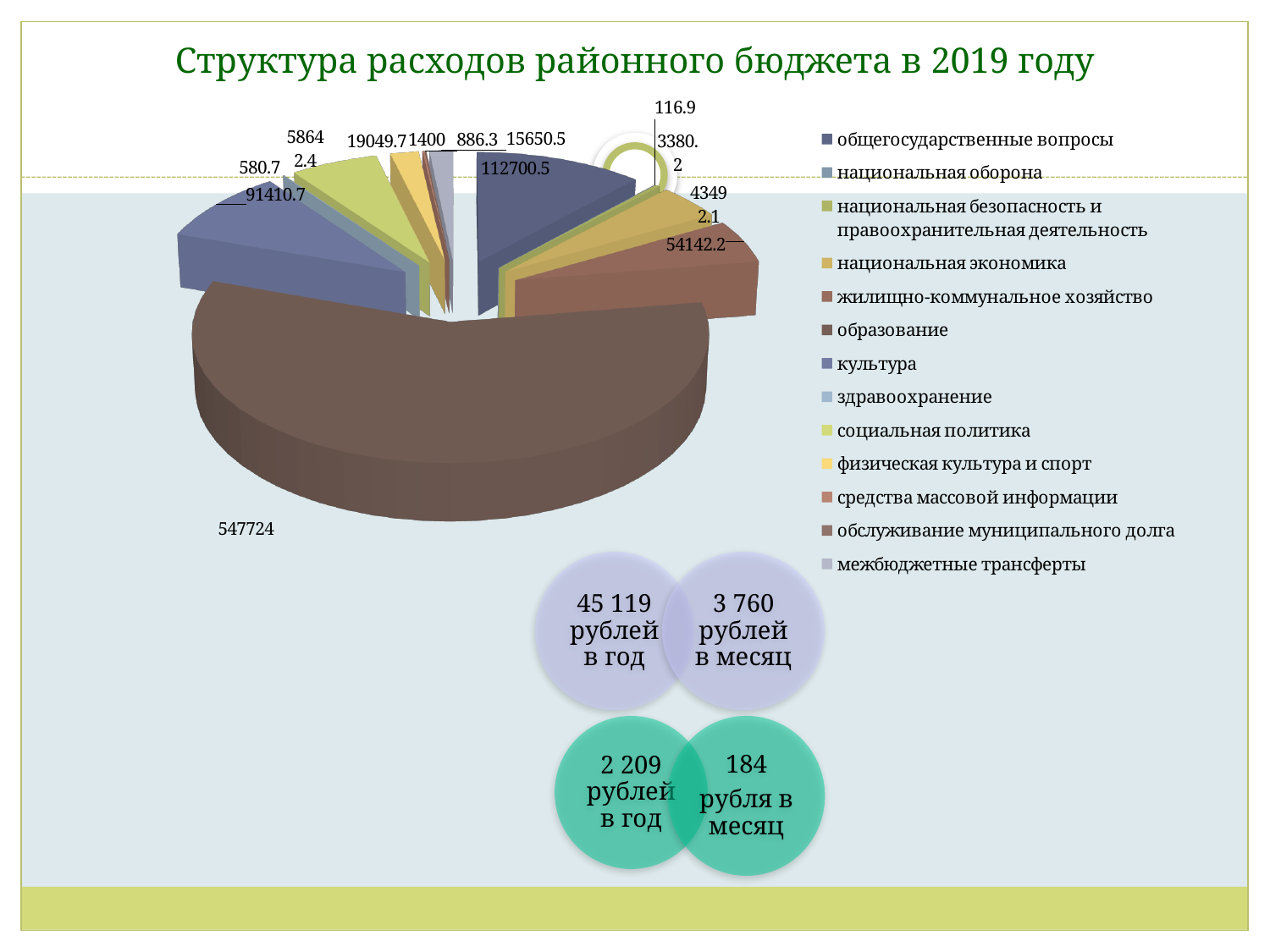
What is the value shown for жилищно-коммунальное хозяйство? 54142.2 Which category has the largest slice in the pie chart? образование What is the value shown for общегосударственные вопросы? 112700.5 What is the difference between the values for образование and общегосударственные вопросы? 435023.5 How many categories does the legend of the pie chart list? 13 What kind of chart is shown on the slide? pie chart What is the title of the chart? Структура расходов районного бюджета в 2019 году What colour is the slice for образование in the pie chart? dark brown What is the value shown for культура? 91410.7 Which is larger, the value for культура or the value for жилищно-коммунальное хозяйство? культура Which is larger, the value for образование or the value for общегосударственные вопросы? образование What is the value shown for образование? 547724